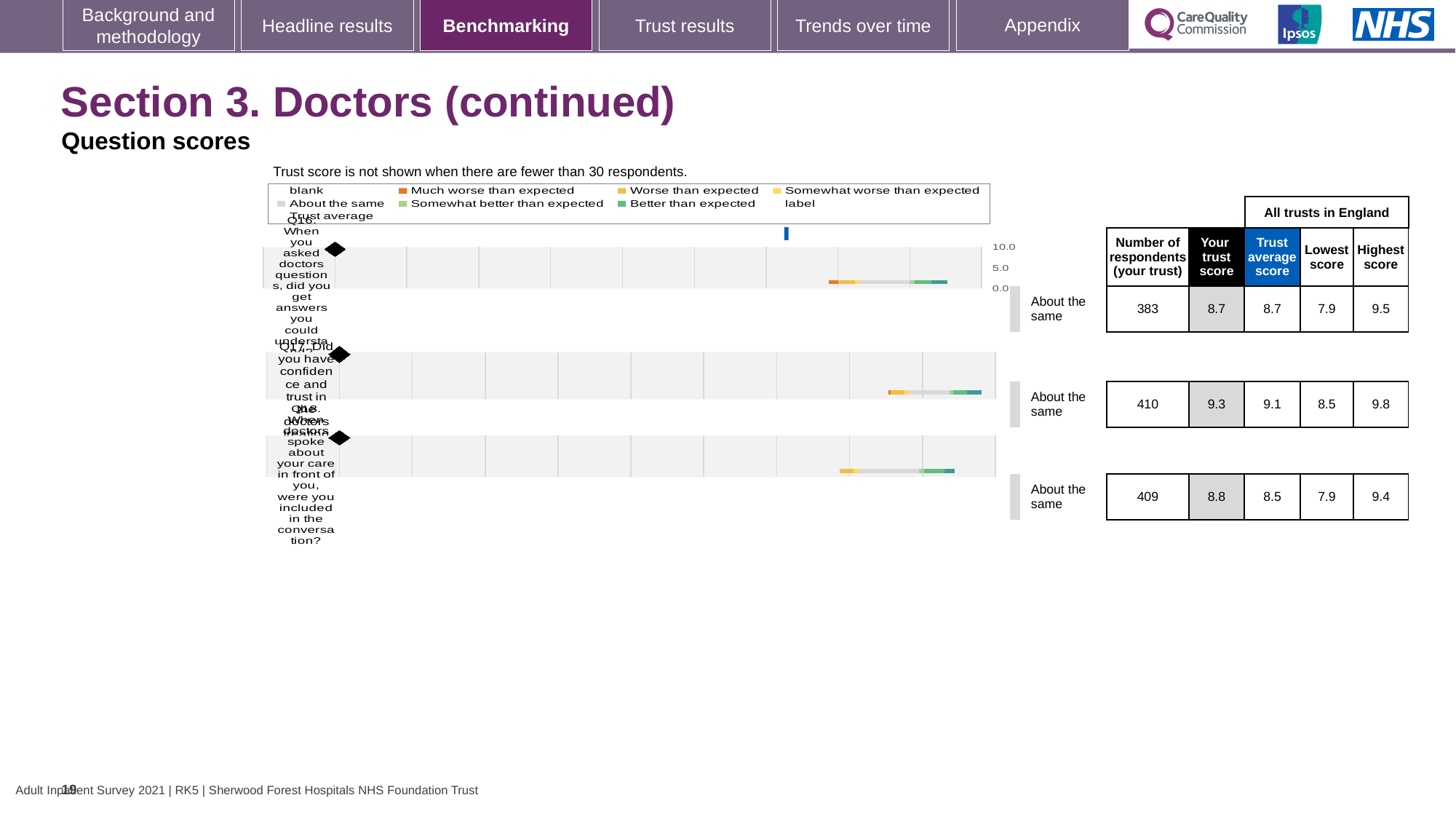
Which question has the highest 'Your trust score'? Q17 Is your trust score for Q17 greater or less than 5.0? greater What is the lowest score across all trusts in England for Q17? 8.5 For Q17, what is the difference between the highest score and the lowest score? 1.3 What is the 'Your trust score' for Q17 (confidence and trust in the doctors)? 9.3 Which question has the lowest number of respondents? Q16 Which is larger: your trust score for Q17 or your trust score for Q18? Q17 What benchmark category is shown for Q16? About the same What is the highest score across all trusts in England for Q18? 9.4 How many questions are plotted in the chart? 3 For Q18, what is the difference between your trust score and the trust average score? 0.3 How many respondents (your trust) are shown for Q16? 383